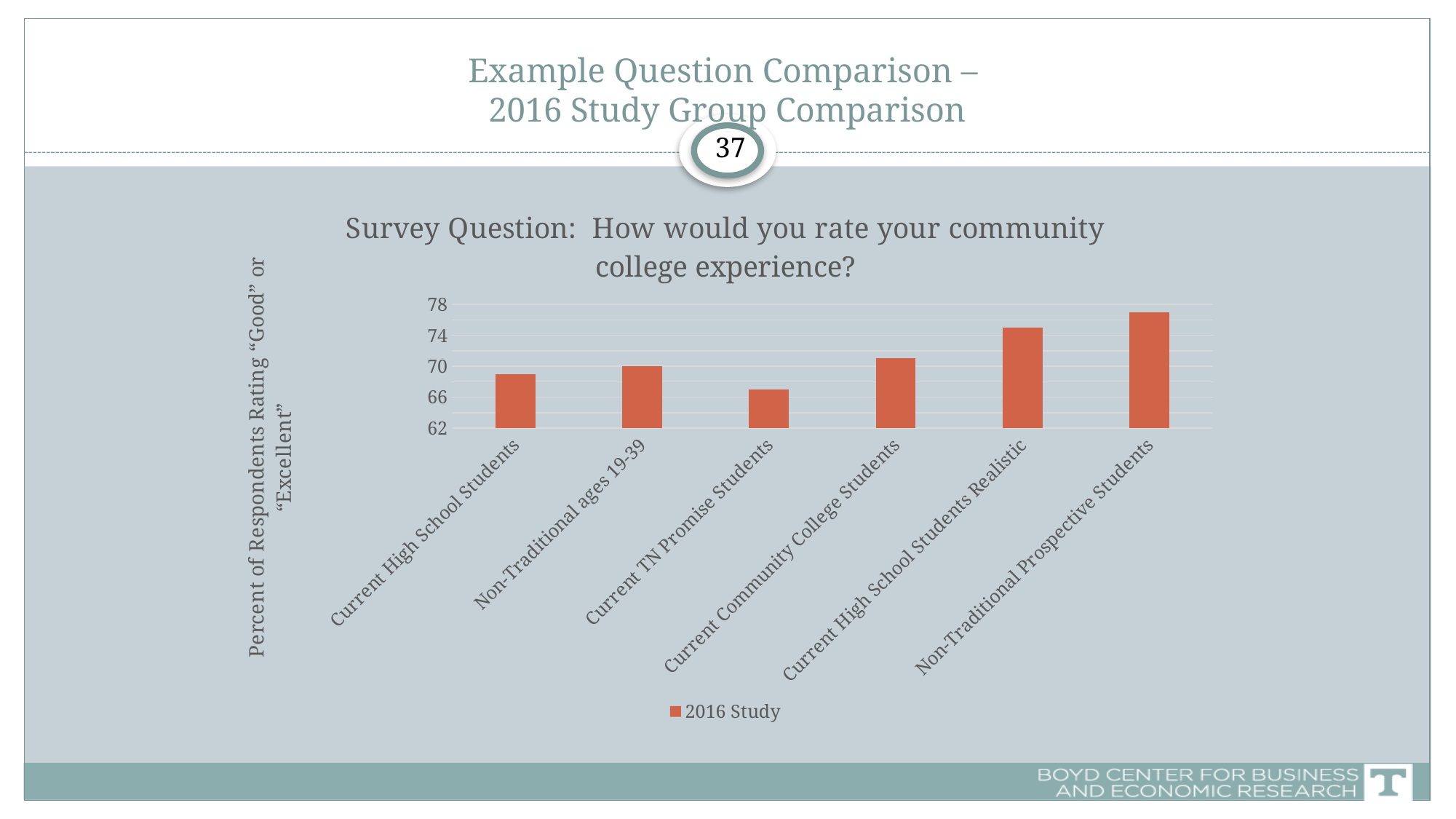
Which study group has the lowest percentage rating their community college experience "Good" or "Excellent"? Current TN Promise Students Is the value for Current High School Students greater or less than 70? less What survey question does the chart title say the data is about? How would you rate your community college experience? Is the value for Current High School Students Realistic greater or less than 74? greater Is the value for Current TN Promise Students greater or less than 70? less Which study group has the highest percentage rating their community college experience "Good" or "Excellent"? Non-Traditional Prospective Students How many categories (study groups) are plotted on the chart? 6 What kind of chart is shown on the slide? bar chart What is the name of the series shown in the chart's legend? 2016 Study How many series does the chart's legend list? 1 Which is larger, the value for Current High School Students Realistic or the value for Current Community College Students? Current High School Students Realistic